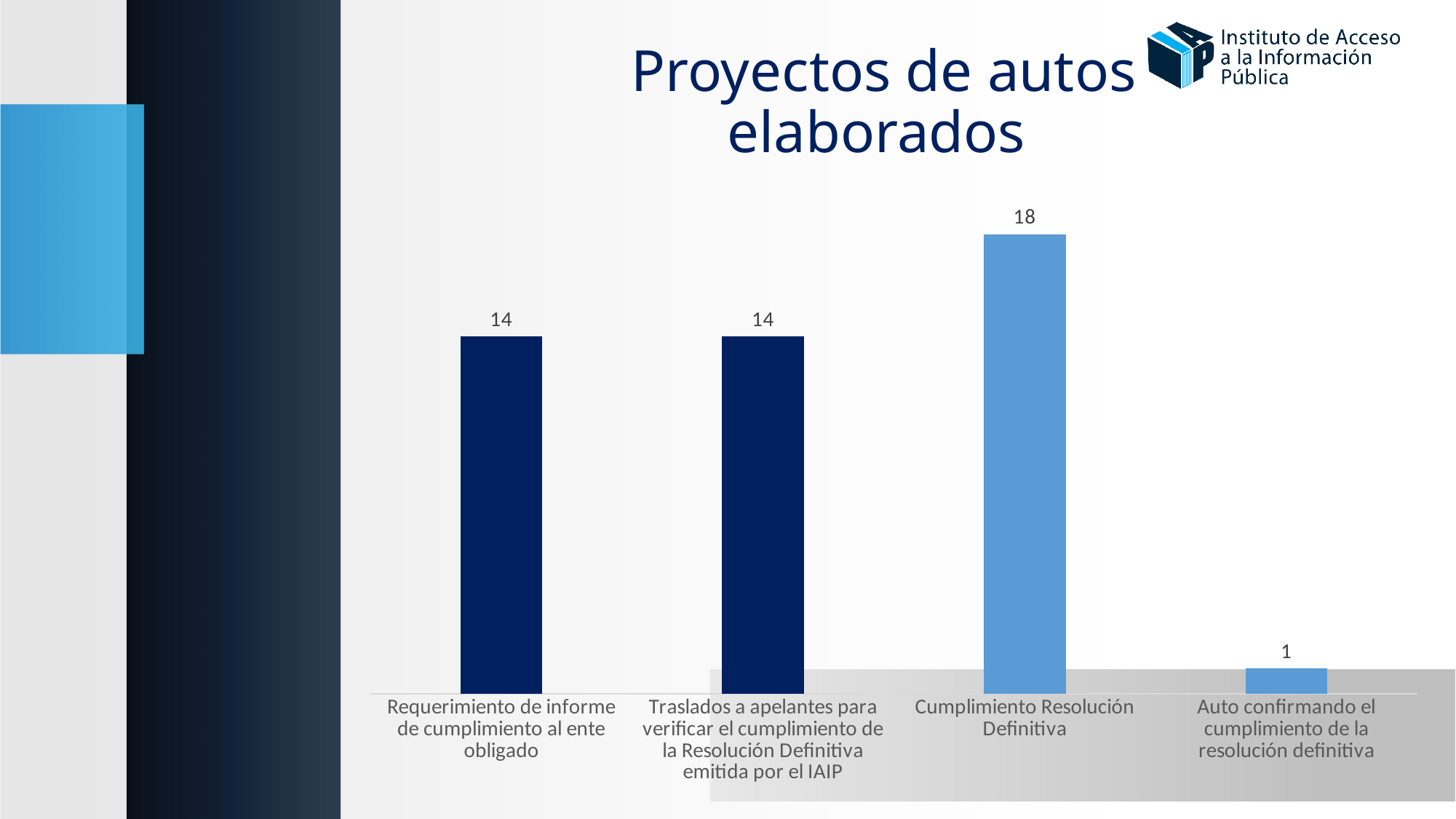
Which category has the highest value? Cumplimiento Resolución Definitiva What is the value for "Traslados a apelantes para verificar el cumplimiento de la Resolución Definitiva emitida por el IAIP"? 14 Which category has the lowest value? Auto confirmando el cumplimiento de la resolución definitiva What kind of chart is shown on the slide? Bar chart How many categories are shown in the chart? 4 What is the difference between the values for "Cumplimiento Resolución Definitiva" and "Requerimiento de informe de cumplimiento al ente obligado"? 4 What is the value for "Requerimiento de informe de cumplimiento al ente obligado"? 14 What is the title of the slide? Proyectos de autos elaborados What is the difference between the values for "Cumplimiento Resolución Definitiva" and "Auto confirmando el cumplimiento de la resolución definitiva"? 17 What is the value for "Auto confirmando el cumplimiento de la resolución definitiva"? 1 What is the value for "Cumplimiento Resolución Definitiva"? 18 Which is larger: the value for "Cumplimiento Resolución Definitiva" or the value for "Traslados a apelantes para verificar el cumplimiento de la Resolución Definitiva emitida por el IAIP"? Cumplimiento Resolución Definitiva